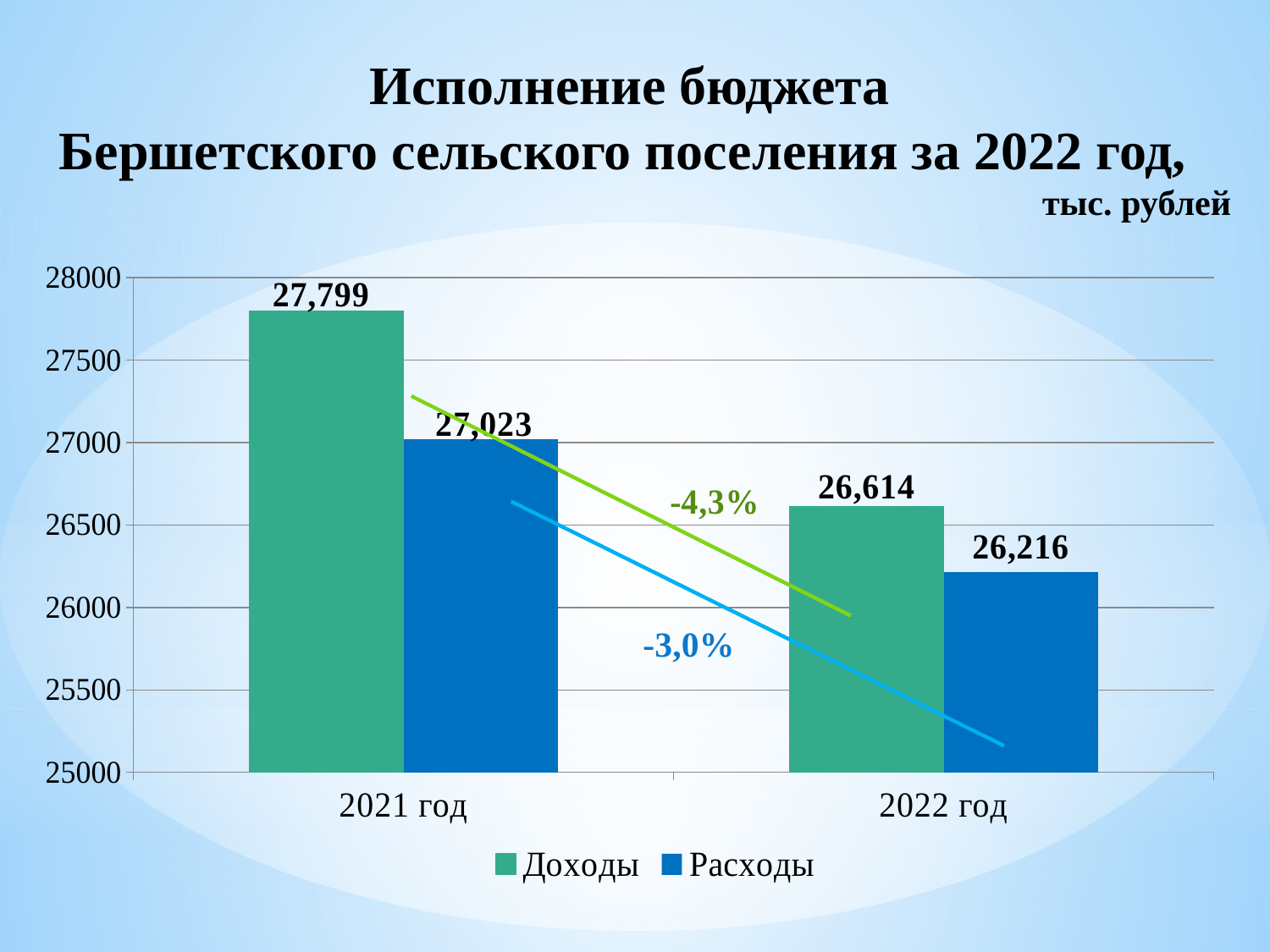
What is the value of Расходы for 2021 год? 27,023 What is the value of Расходы for 2022 год? 26,216 Which is larger: Расходы in 2021 год or Доходы in 2022 год? Расходы in 2021 год What is the value of Доходы for 2022 год? 26,614 Which bar has the lowest value on the chart? Расходы, 2022 год How many series does the legend list? 2 What is the difference between Доходы in 2021 год and Доходы in 2022 год? 1,185 What percentage change is labelled on the green trend line for Доходы? -4,3% What is the value of Доходы for 2021 год? 27,799 What kind of chart is shown on the slide? Bar chart What is the difference between Доходы and Расходы in 2021 год? 776 Which bar has the highest value on the chart? Доходы, 2021 год